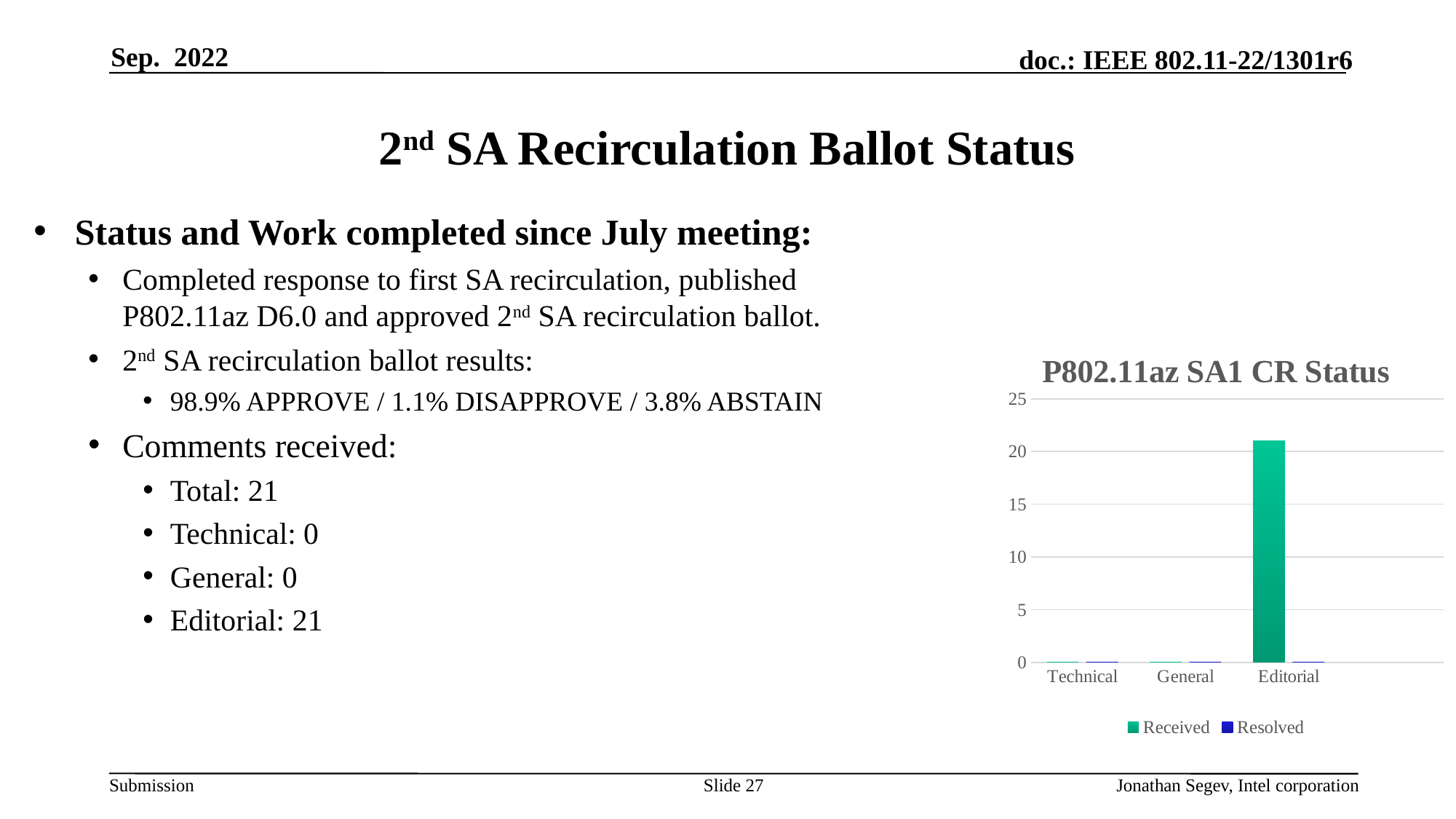
Which category has the highest Received value in the chart? Editorial Is the Received value for Editorial greater or less than 25? less How many categories are shown on the x axis of the chart? 3 Which has a larger Received value, Editorial or General? Editorial Is the Received value for Editorial greater or less than 20? greater What is the highest value shown on the chart's vertical axis? 25 What is the title of the chart on the slide? P802.11az SA1 CR Status How many series does the chart's legend list? 2 Which series are listed in the chart's legend? Received and Resolved What kind of chart is shown on the slide? bar chart Is the Received value for Technical greater or less than 5? less Which has a larger Received value, Technical or Editorial? Editorial